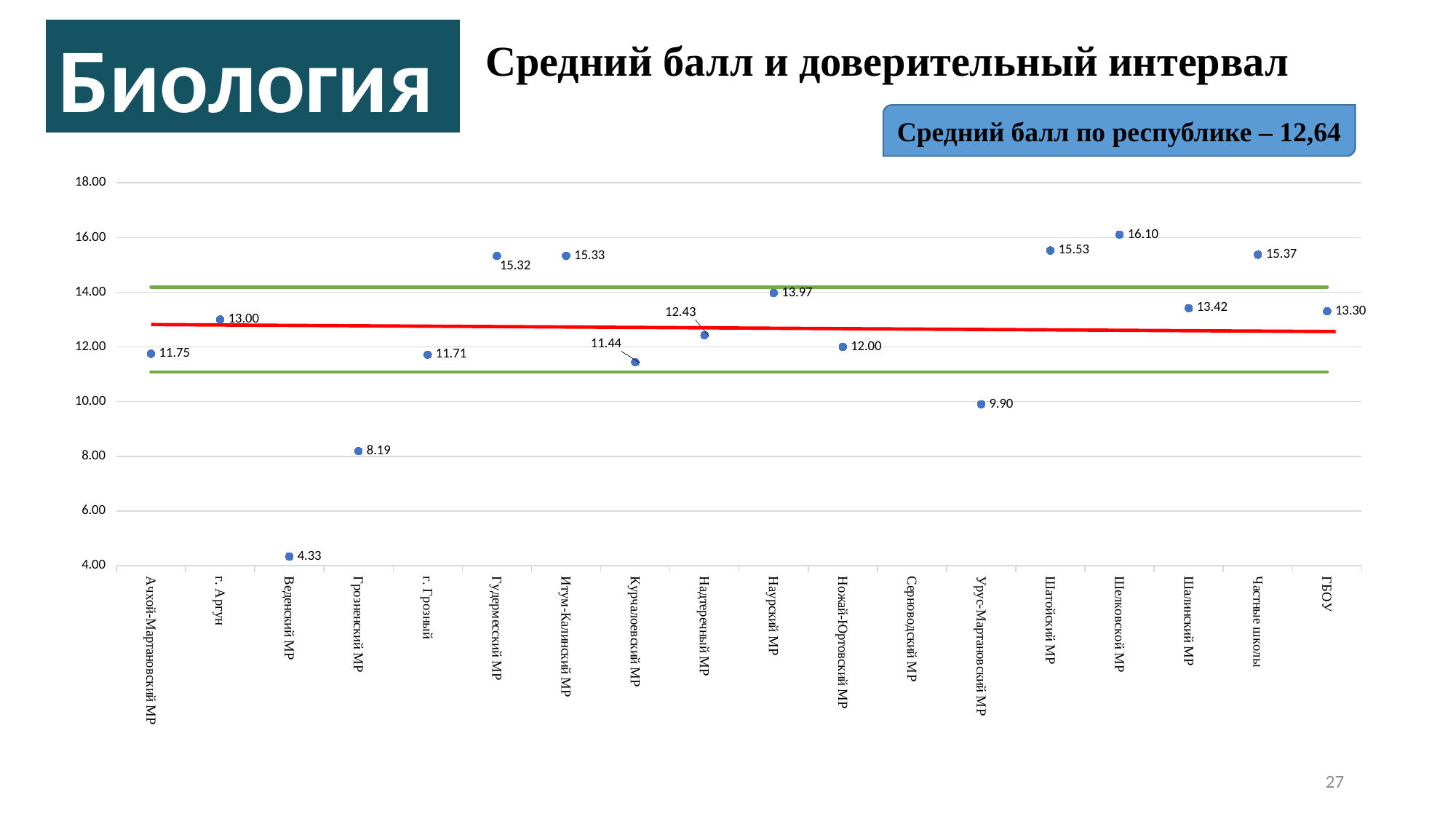
What is the value for Частные школы? 15.37 Which is larger, the value for Гудермесский МР or the value for Урус-Мартановский МР? Гудермесский МР What is the value for Шелковской МР? 16.10 What is the value for Веденский МР? 4.33 Which category has the highest value? Шелковской МР What kind of chart is shown on the slide? scatter chart What is the average score for the republic stated on the slide? 12,64 How many category labels are shown on the x axis? 18 What is the difference between the values for Шатойский МР and Грозненский МР? 7.34 Which category has the lowest value? Веденский МР Is the value for Курчалоевский МР greater or less than 12.00? less What is the value for Наурский МР? 13.97